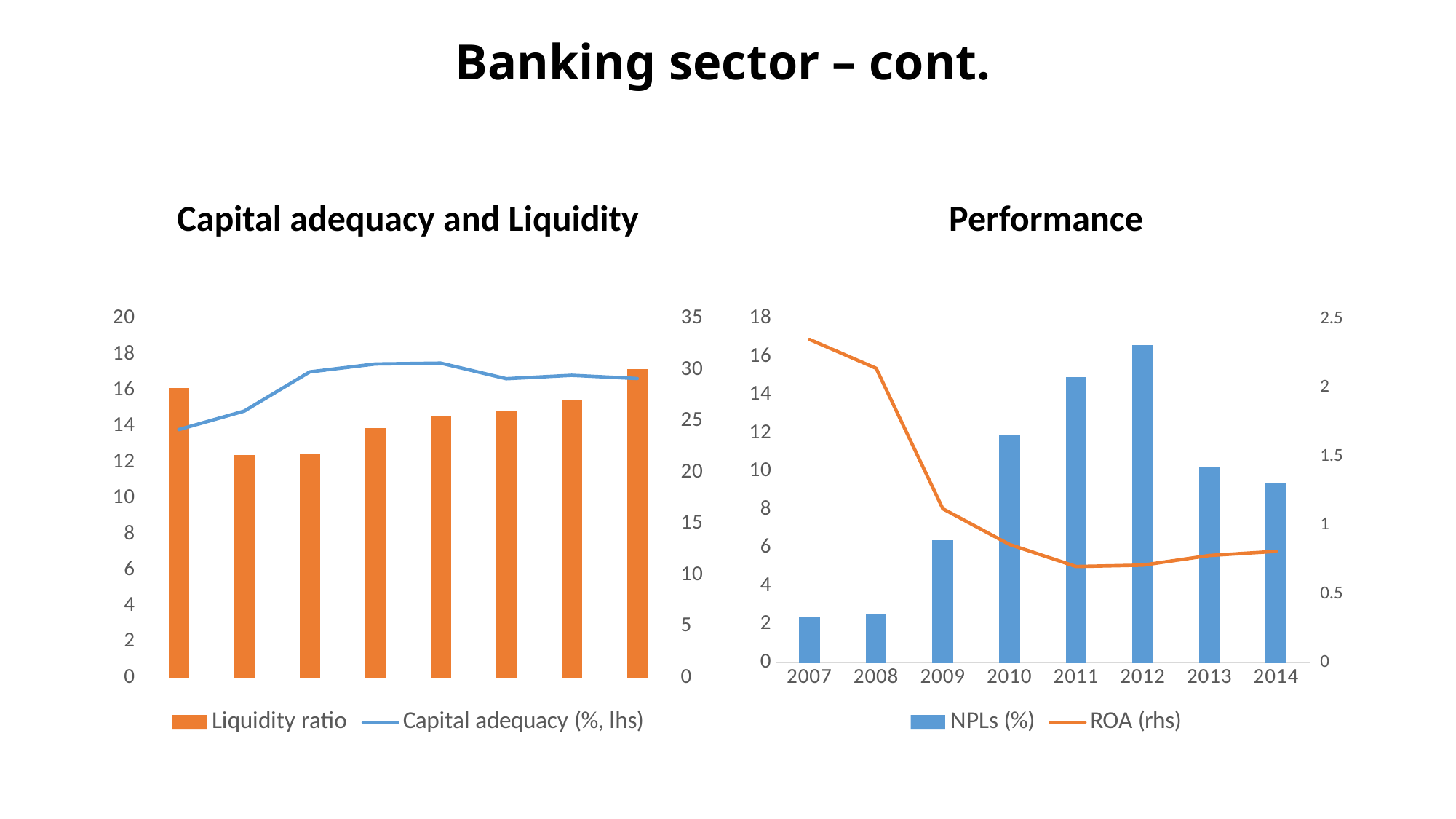
In the Performance chart, which year has the larger NPLs (%) value, 2011 or 2013? 2011 In the Performance chart, is the NPLs (%) value for 2012 greater or less than 15? greater In the Performance chart, does the ROA (rhs) line rise or fall from 2007 to 2011? fall What kind of chart is the Capital adequacy and Liquidity chart? Combined bar and line chart In the Performance chart, is the NPLs (%) value for 2010 greater or less than 10? greater In the Performance chart, is the NPLs (%) value for 2009 greater or less than 8? less How many series does the legend of the Performance chart list? 2 In the Performance chart, which year has the highest NPLs (%) value? 2012 What are the two legend entries of the Capital adequacy and Liquidity chart? Liquidity ratio; Capital adequacy (%, lhs) How many bars are plotted in the Capital adequacy and Liquidity chart? 8 How many years are shown on the x axis of the Performance chart? 8